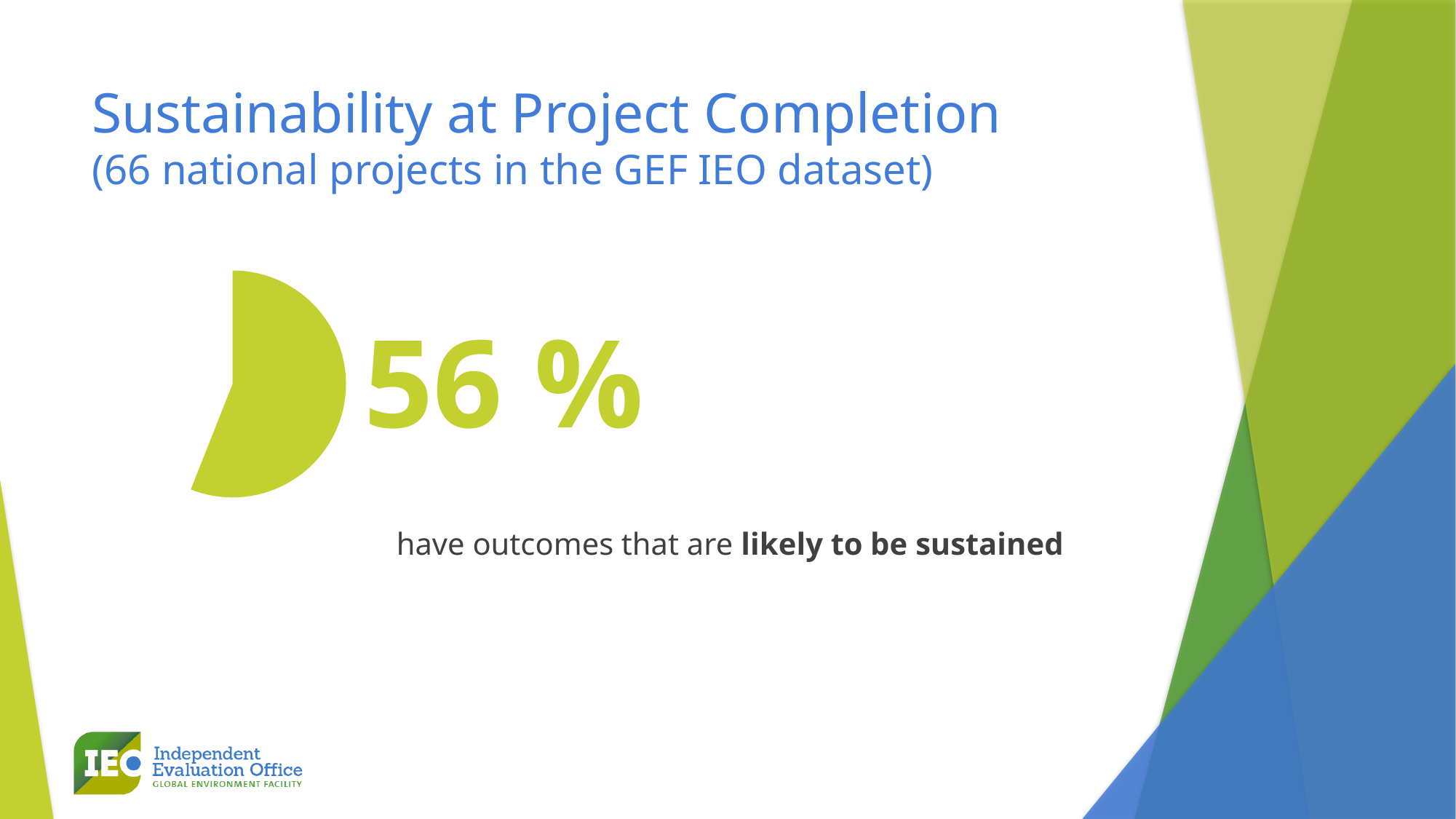
What percentage is shown by the pie slice on the slide? 56 % What is the title of the chart on the slide? Sustainability at Project Completion Is the share of projects with outcomes likely to be sustained greater or less than 50%? greater What share of projects have outcomes that are likely to be sustained? 56 % What kind of chart is shown on the slide? pie chart How many national projects are in the GEF IEO dataset according to the chart title? 66 What does the 56 % slice represent? projects with outcomes that are likely to be sustained